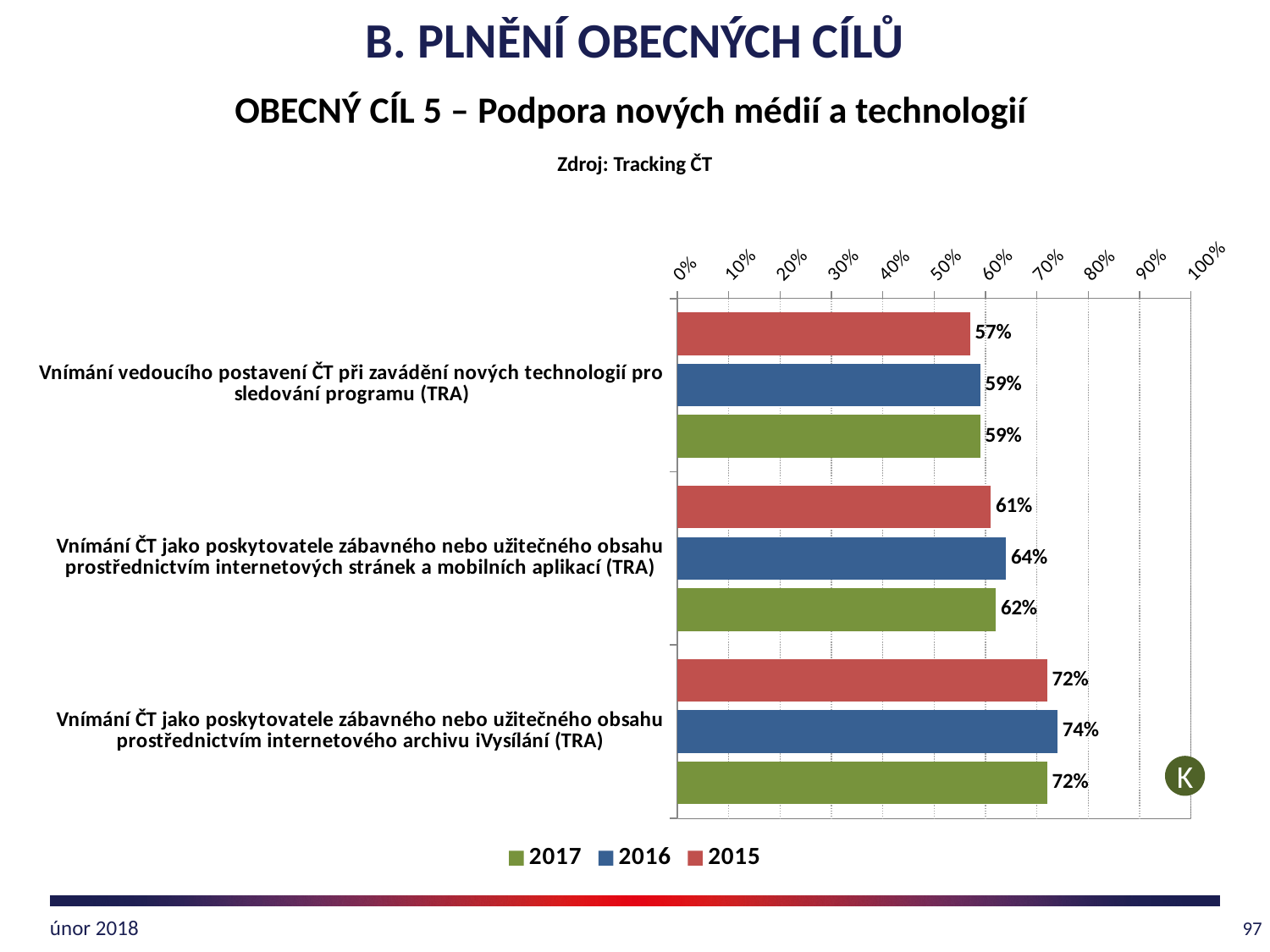
Which category has the lowest 2015 value? Vnímání vedoucího postavení ČT při zavádění nových technologií pro sledování programu (TRA) What is the difference between the 2016 and 2015 values for 'Vnímání ČT jako poskytovatele zábavného nebo užitečného obsahu prostřednictvím internetových stránek a mobilních aplikací (TRA)'? 3% How many categories are plotted on the chart? 3 What is the 2015 value for 'Vnímání vedoucího postavení ČT při zavádění nových technologií pro sledování programu (TRA)'? 57% What kind of chart is shown on the slide? bar chart Which colour represents the 2015 series in the legend? red Which category has the highest 2016 value? Vnímání ČT jako poskytovatele zábavného nebo užitečného obsahu prostřednictvím internetového archivu iVysílání (TRA) How many series does the legend list? 3 For 'Vnímání ČT jako poskytovatele zábavného nebo užitečného obsahu prostřednictvím internetového archivu iVysílání (TRA)', which is larger: the 2016 value or the 2017 value? 2016 What is the 2017 value for 'Vnímání ČT jako poskytovatele zábavného nebo užitečného obsahu prostřednictvím internetového archivu iVysílání (TRA)'? 72% What is the 2016 value for 'Vnímání ČT jako poskytovatele zábavného nebo užitečného obsahu prostřednictvím internetových stránek a mobilních aplikací (TRA)'? 64% Is the 2017 value for 'Vnímání ČT jako poskytovatele zábavného nebo užitečného obsahu prostřednictvím internetového archivu iVysílání (TRA)' greater or less than 70%? greater